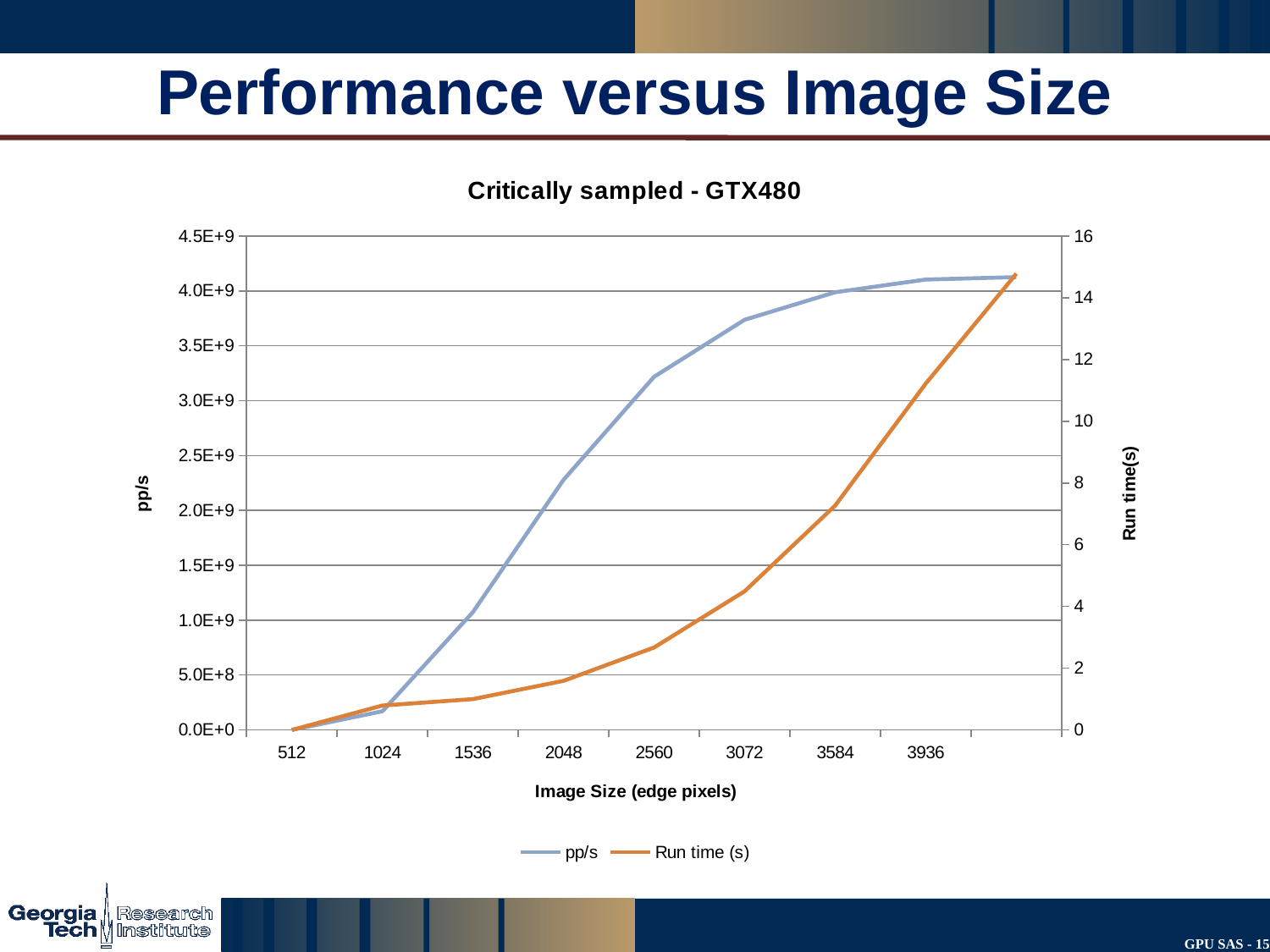
How many series does the legend list? 2 Is the Run time (s) value at image size 3072 greater or less than 6? less Does the pp/s series rise or fall as image size increases along the x axis? rise Does the Run time (s) series rise or fall as image size increases along the x axis? rise Is the Run time (s) value at image size 3584 greater or less than 6? greater What kind of chart is shown on the slide? line chart Is the Run time (s) value at image size 2048 greater or less than 2? less What is the title of the chart? Critically sampled - GTX480 What is the label of the x axis? Image Size (edge pixels)